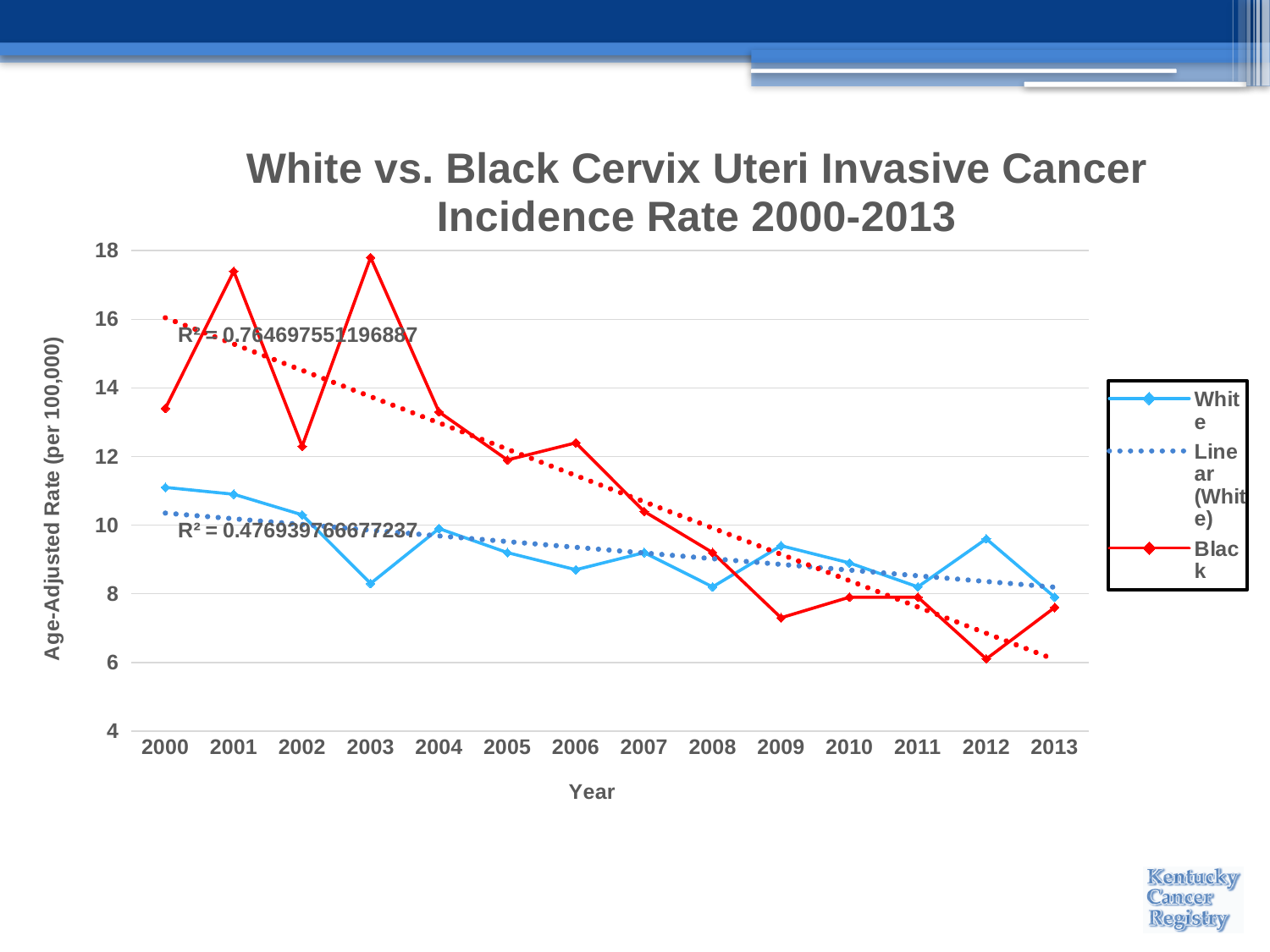
In which year is the Black incidence rate lowest? 2012 In 2009, which series has the higher incidence rate, White or Black? White In which year is the Black incidence rate highest? 2003 Is the White incidence rate in 2003 greater or less than 10? less What kind of chart is shown on the slide? line chart How many entries does the legend list? 3 Does the Black incidence rate generally rise or fall from 2000 to 2013? fall Is the Black incidence rate in 2009 greater or less than 8? less Is the Black incidence rate in 2001 greater or less than 16? greater How many years are plotted along the x axis? 14 In 2000, which series has the higher incidence rate, White or Black? Black In which year is the White incidence rate lowest? 2013